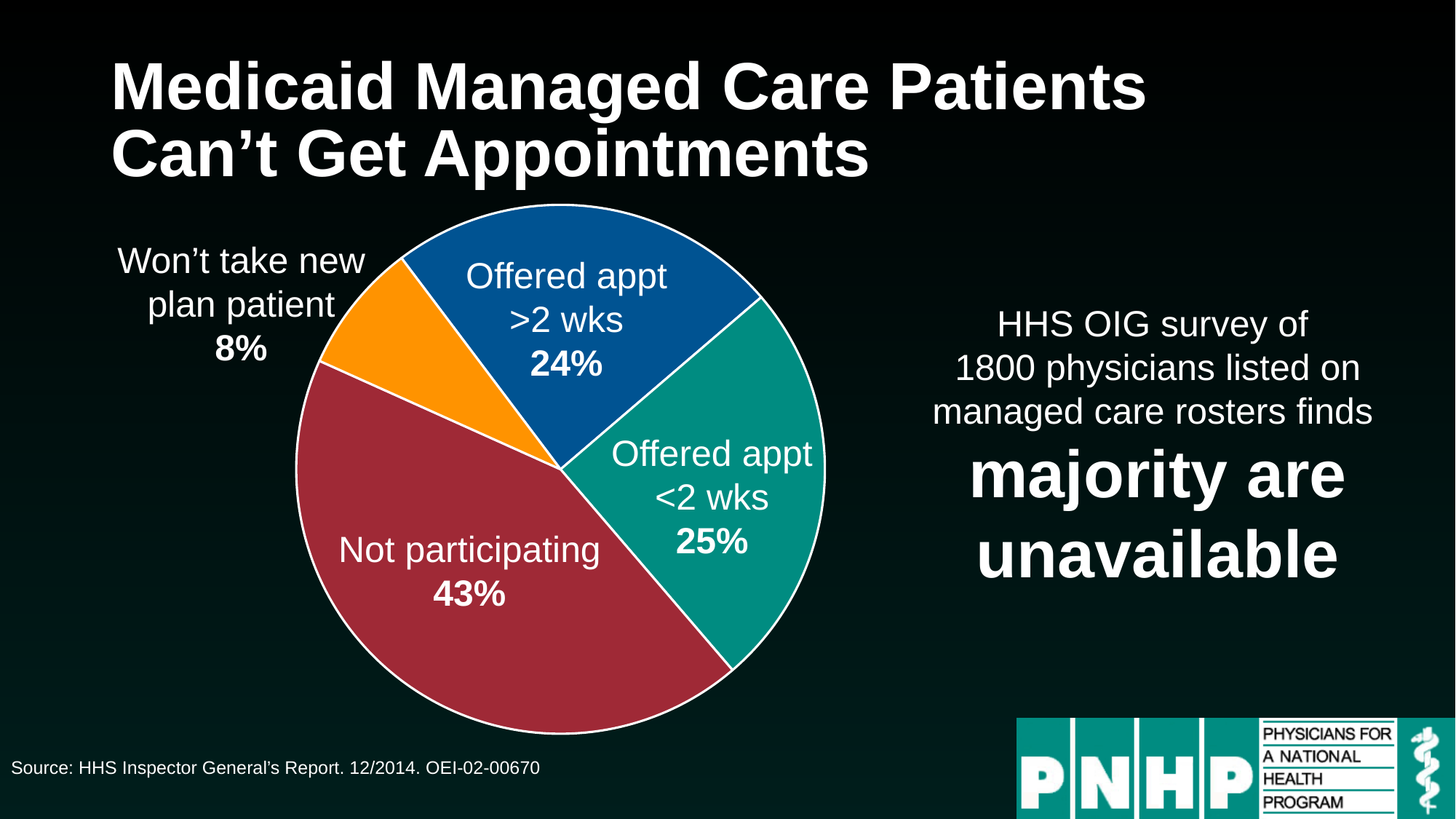
Which slice of the pie is the largest? Not participating How many slices does the pie chart have? 4 Which is larger: 'Offered appt >2 wks' or 'Won't take new plan patient'? Offered appt >2 wks What colour is the 'Not participating' slice? Red What kind of chart is shown on the slide? Pie chart Which slice of the pie is the smallest? Won't take new plan patient What percentage of physicians offered an appointment in more than 2 weeks? 24% What is the combined percentage of 'Not participating' and 'Won't take new plan patient'? 51% What is the difference in percentage points between 'Not participating' and 'Offered appt <2 wks'? 18 What percentage of physicians offered an appointment in less than 2 weeks? 25% What percentage of physicians won't take a new plan patient? 8% What percentage of physicians are shown as 'Not participating'? 43%